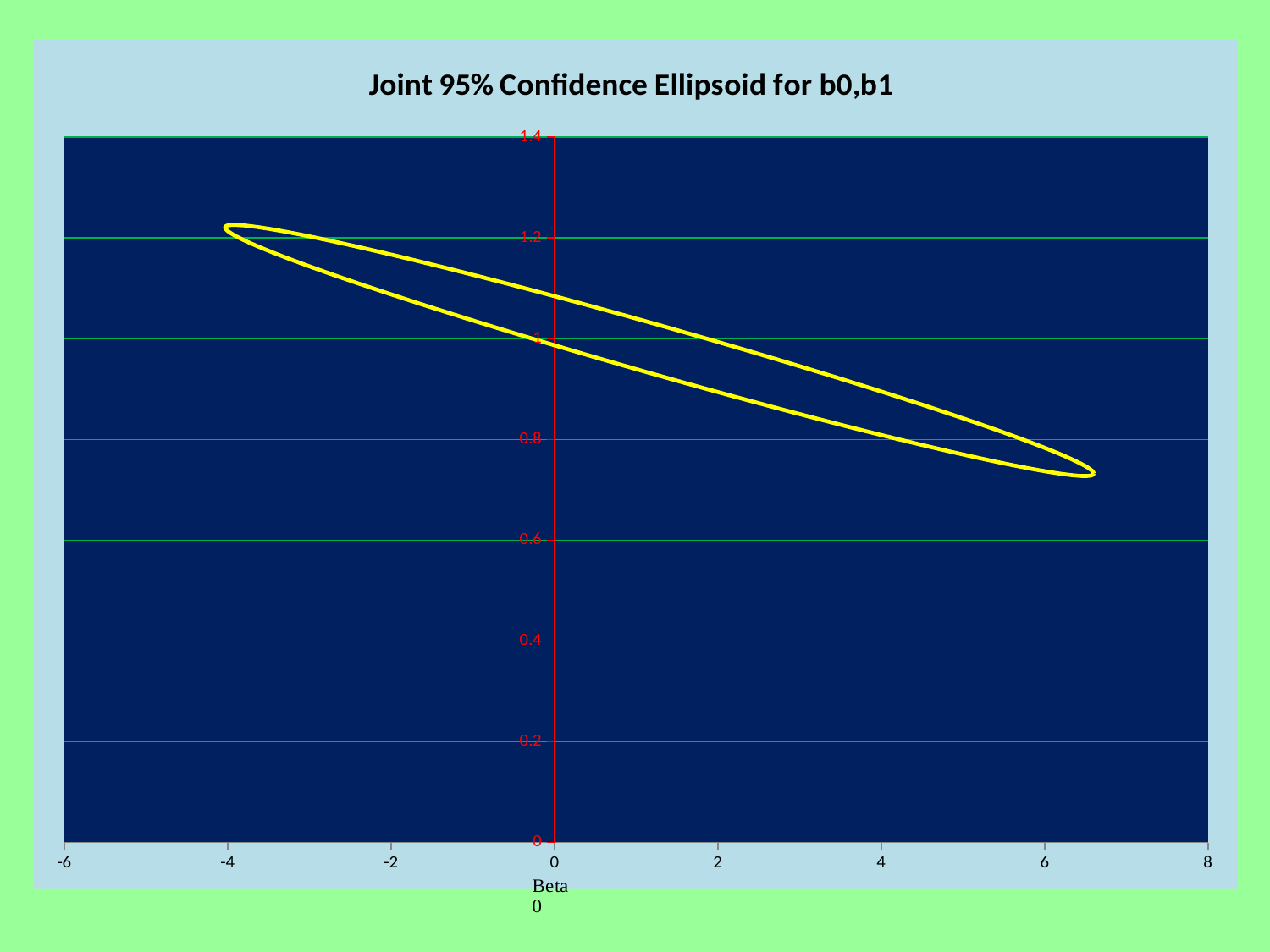
Is the rightmost point of the ellipse greater or less than 6 on the Beta 0 axis? greater What is the title of the chart? Joint 95% Confidence Ellipsoid for b0,b1 What is the label on the horizontal axis of the chart? Beta 0 Is the lowest point of the ellipse greater or less than 0.6 on the vertical axis? greater What kind of chart is shown on the slide? line chart How many curves (series) are plotted on the chart? 1 Does the ellipse slope upward or downward as Beta 0 increases from left to right? downward Is the leftmost point of the ellipse greater or less than -6 on the Beta 0 axis? greater Which end of the ellipse is higher on the vertical axis, the left end or the right end? the left end